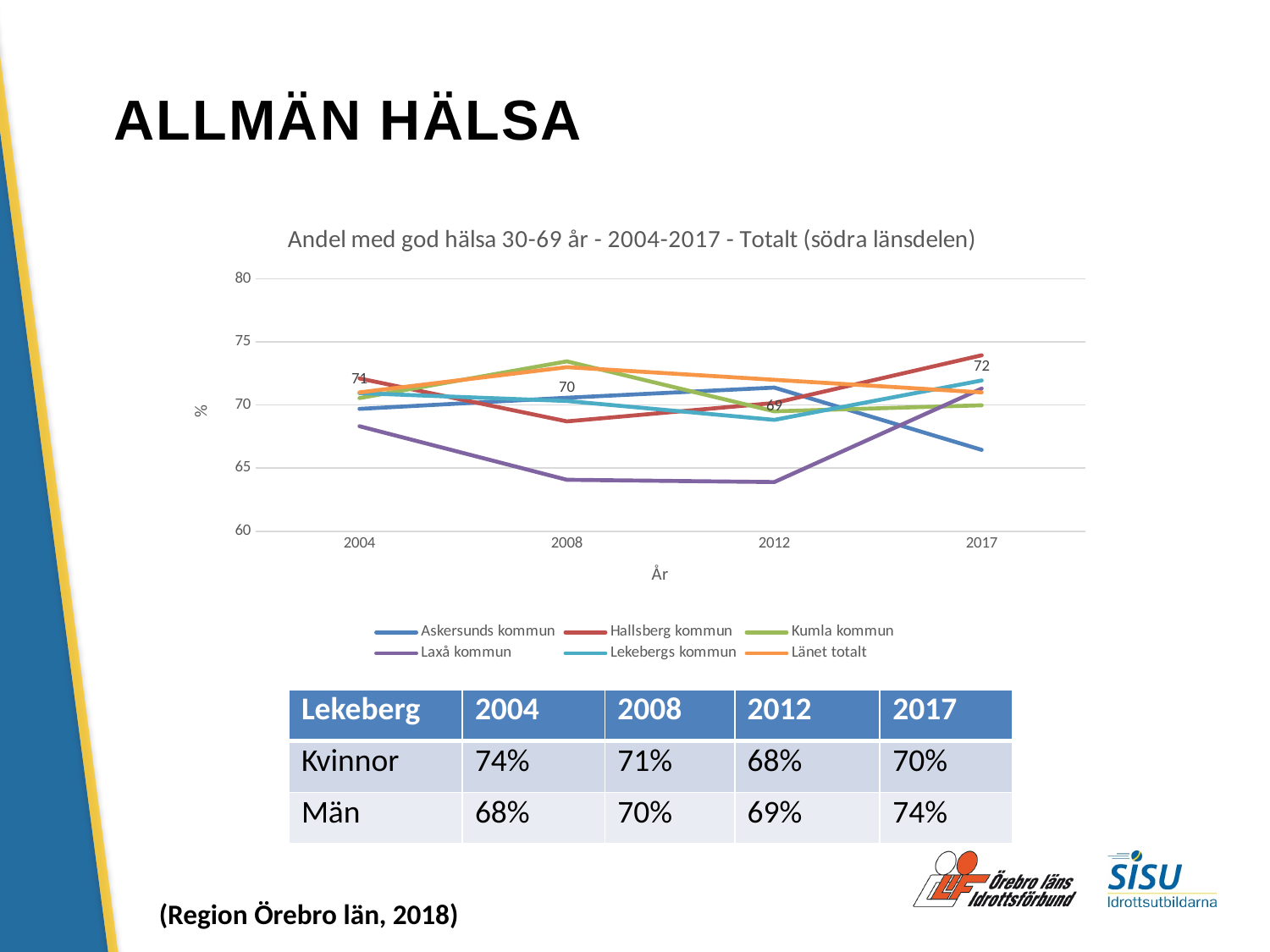
Is the value for Hallsberg kommun in 2017 greater or less than 70? greater In 2017, which is larger: the value for Hallsberg kommun or the value for Askersunds kommun? Hallsberg kommun What kind of chart is shown on the slide? line chart How many series does the chart legend list? 6 How many years are plotted along the x axis of the chart? 4 What is the title of the chart? Andel med god hälsa 30-69 år - 2004-2017 - Totalt (södra länsdelen) Is the value for Askersunds kommun in 2017 greater or less than 70? less Which series has the lowest value in 2017? Askersunds kommun Which municipality has the lowest value in 2012? Laxå kommun Which series has the highest value in 2017? Hallsberg kommun Is the value for Laxå kommun in 2008 greater or less than 65? less Does the value for Laxå kommun rise or fall from 2004 to 2012? fall